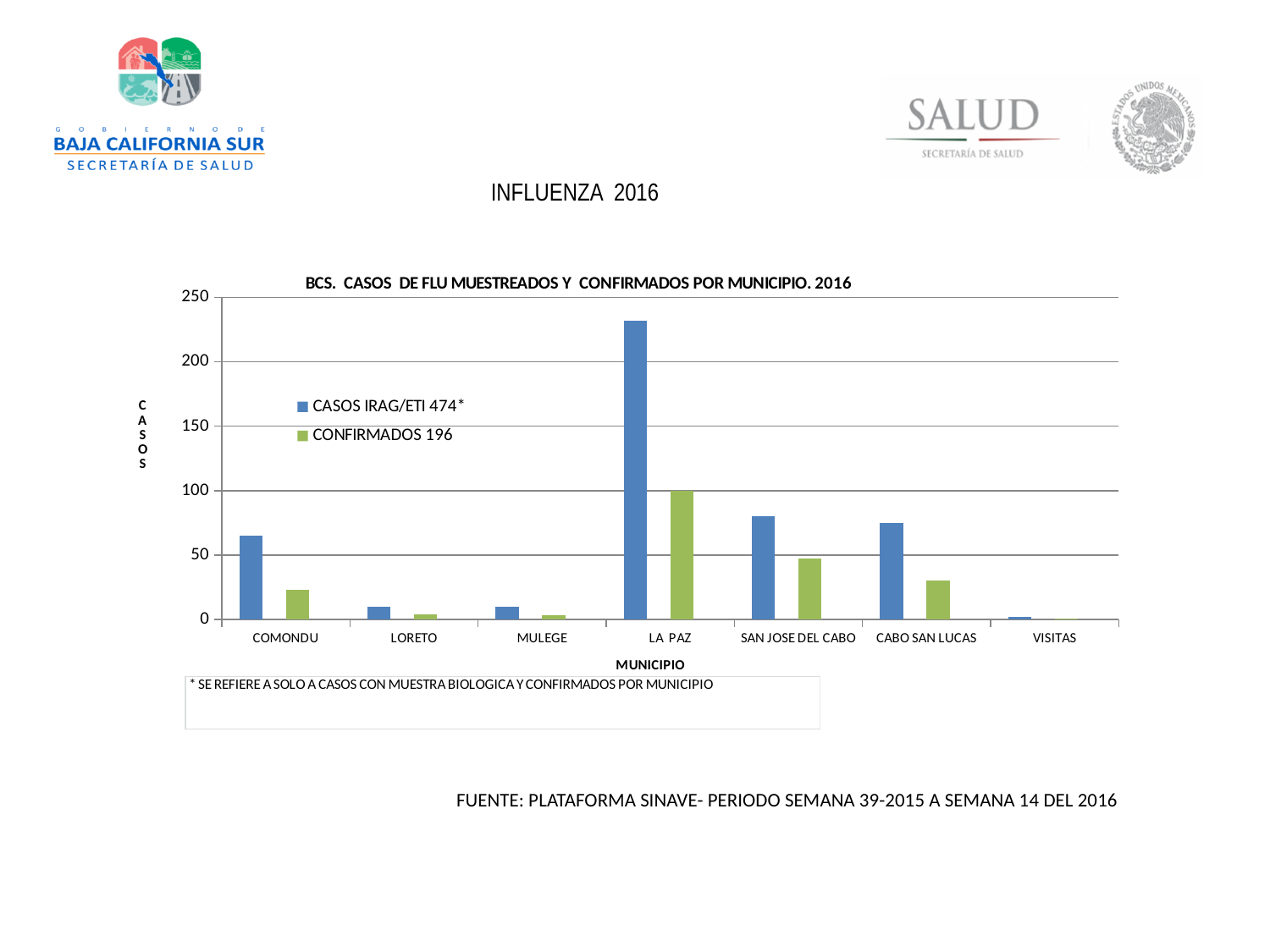
Is the CONFIRMADOS 196 value for CABO SAN LUCAS greater or less than 50? less Which municipality has the highest value for CONFIRMADOS 196? LA PAZ Is the CASOS IRAG/ETI 474* value for SAN JOSE DEL CABO greater or less than 100? less How many municipalities (categories) are shown on the x axis of the chart? 7 Is the CASOS IRAG/ETI 474* value for LA PAZ greater or less than 200? greater Which has a larger CONFIRMADOS 196 value, SAN JOSE DEL CABO or CABO SAN LUCAS? SAN JOSE DEL CABO How many series does the chart's legend list? 2 Which municipality has the highest value for CASOS IRAG/ETI 474*? LA PAZ What is the title of the chart? BCS. CASOS DE FLU MUESTREADOS Y CONFIRMADOS POR MUNICIPIO. 2016 Which municipality has the lowest value for CASOS IRAG/ETI 474*? VISITAS What kind of chart is shown on the slide? bar chart